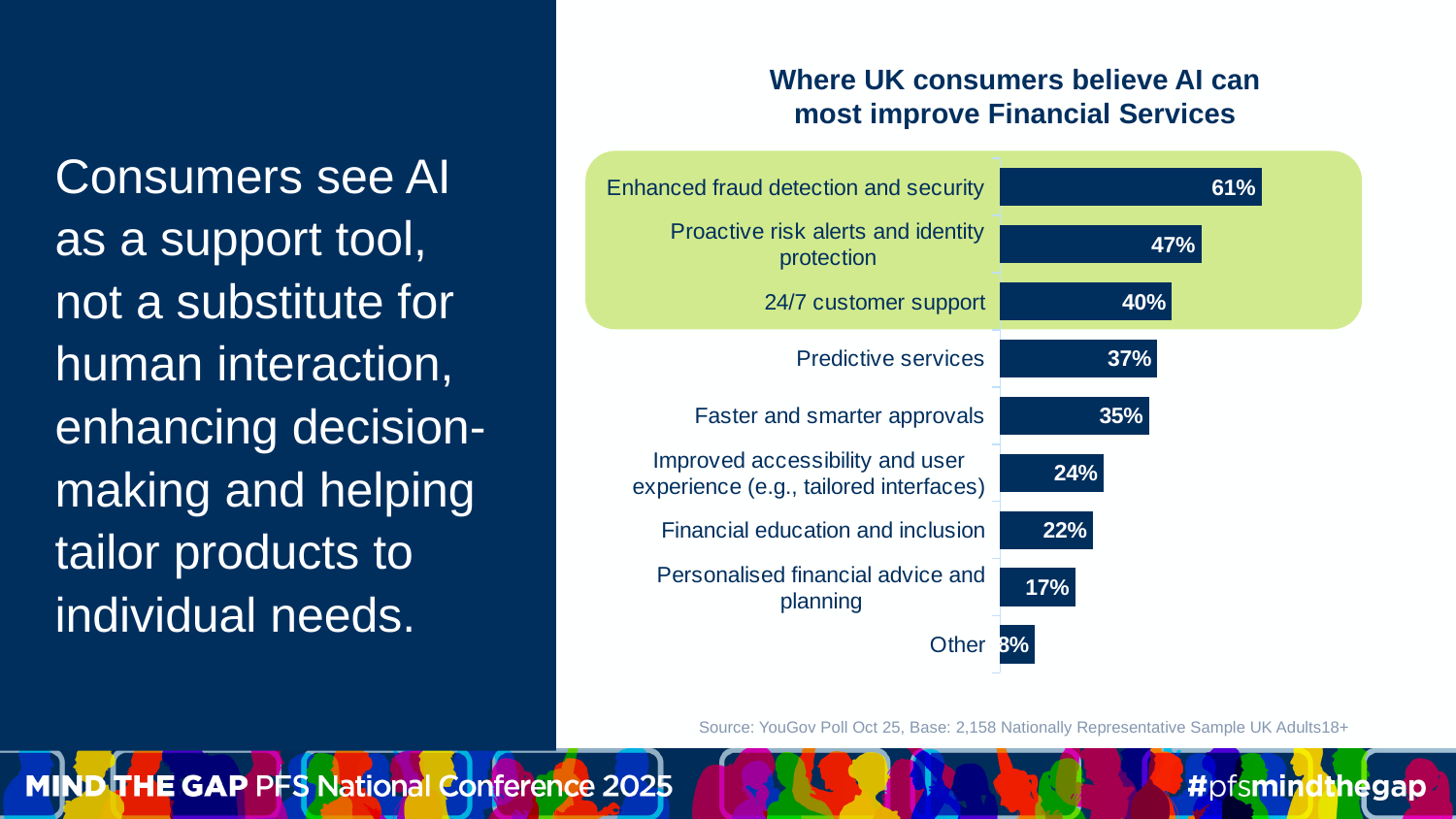
Which category has the highest value in the chart? Enhanced fraud detection and security What is the title of the chart? Where UK consumers believe AI can most improve Financial Services Which is larger: the value for 'Predictive services' or the value for 'Faster and smarter approvals'? Predictive services What is the value for 'Proactive risk alerts and identity protection'? 47% What is the value for 'Personalised financial advice and planning'? 17% What percentage of UK consumers believe AI can most improve Financial Services through enhanced fraud detection and security? 61% How many categories are highlighted with a green background in the chart? 3 What is the difference between the values for '24/7 customer support' and 'Financial education and inclusion'? 18% How many categories are shown in the chart? 9 What is the value for 'Improved accessibility and user experience (e.g., tailored interfaces)'? 24% What kind of chart is shown on the slide? Bar chart Which category has the lowest value in the chart? Other